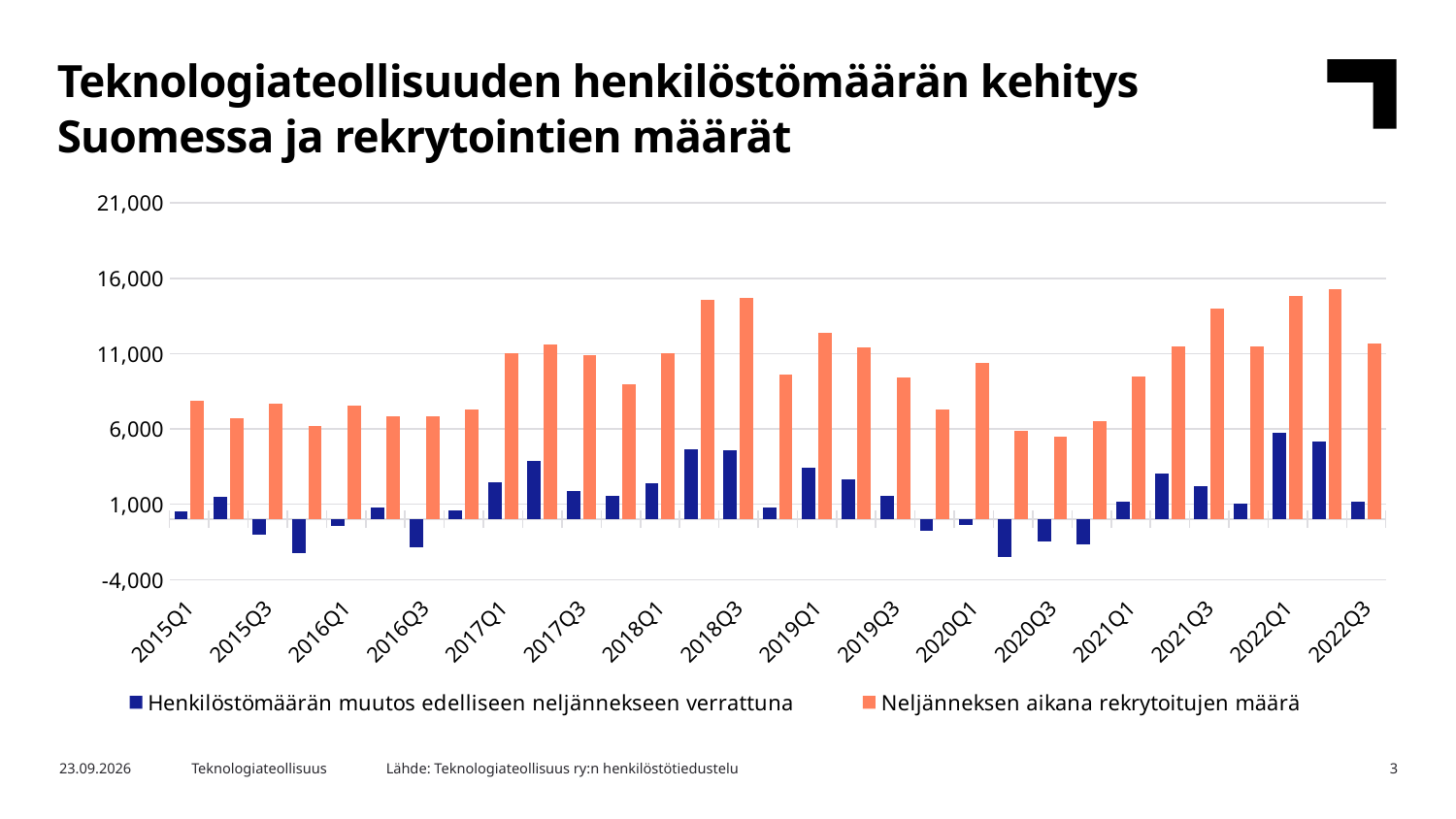
Is the value of 'Neljänneksen aikana rekrytoitujen määrä' for 2018Q3 greater or less than 16,000? less Is the value of 'Neljänneksen aikana rekrytoitujen määrä' for 2020Q3 greater or less than 6,000? less What are the two series named in the legend? Henkilöstömäärän muutos edelliseen neljännekseen verrattuna; Neljänneksen aikana rekrytoitujen määrä Is the value of 'Henkilöstömäärän muutos edelliseen neljännekseen verrattuna' for 2022Q1 greater or less than 1,000? greater Which is larger: the 'Neljänneksen aikana rekrytoitujen määrä' value for 2018Q3 or for 2015Q1? 2018Q3 How many series does the legend list? 2 What kind of chart is shown on the slide? Bar chart Does the 'Neljänneksen aikana rekrytoitujen määrä' series rise or fall from 2020Q3 to 2022Q1? Rise What is the title of the chart? Teknologiateollisuuden henkilöstömäärän kehitys Suomessa ja rekrytointien määrät